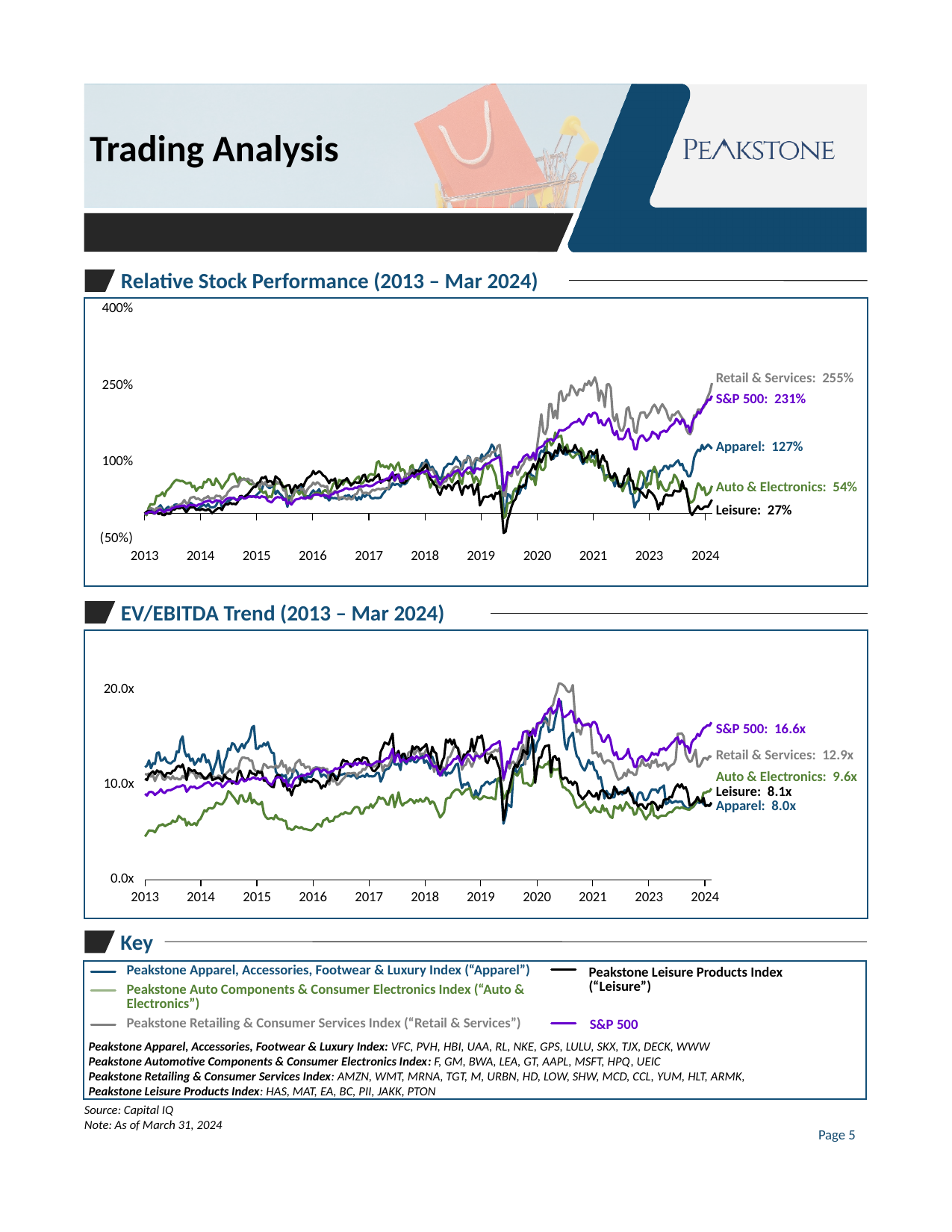
In the Relative Stock Performance chart, what is the difference between the labelled end values for Apparel and Leisure? 100 percentage points In the Relative Stock Performance chart, which series has the highest labelled end value? Retail & Services In the EV/EBITDA Trend chart, what is the end value shown for the S&P 500? 16.6x In the Relative Stock Performance chart, what is the end value shown for Retail & Services? 255% In the EV/EBITDA Trend chart, what is the difference between the labelled end values for the S&P 500 and Retail & Services? 3.7x How many series does the Key list for the charts? 5 In the EV/EBITDA Trend chart, which is larger at the end, Retail & Services or Auto & Electronics? Retail & Services In the Relative Stock Performance chart, which series has the lowest labelled end value? Leisure What kind of chart is the Relative Stock Performance chart? Line chart In the Relative Stock Performance chart, what is the end value shown for the S&P 500? 231% In the EV/EBITDA Trend chart, which series has the highest labelled end value? S&P 500 In the EV/EBITDA Trend chart, what is the end value shown for Leisure? 8.1x